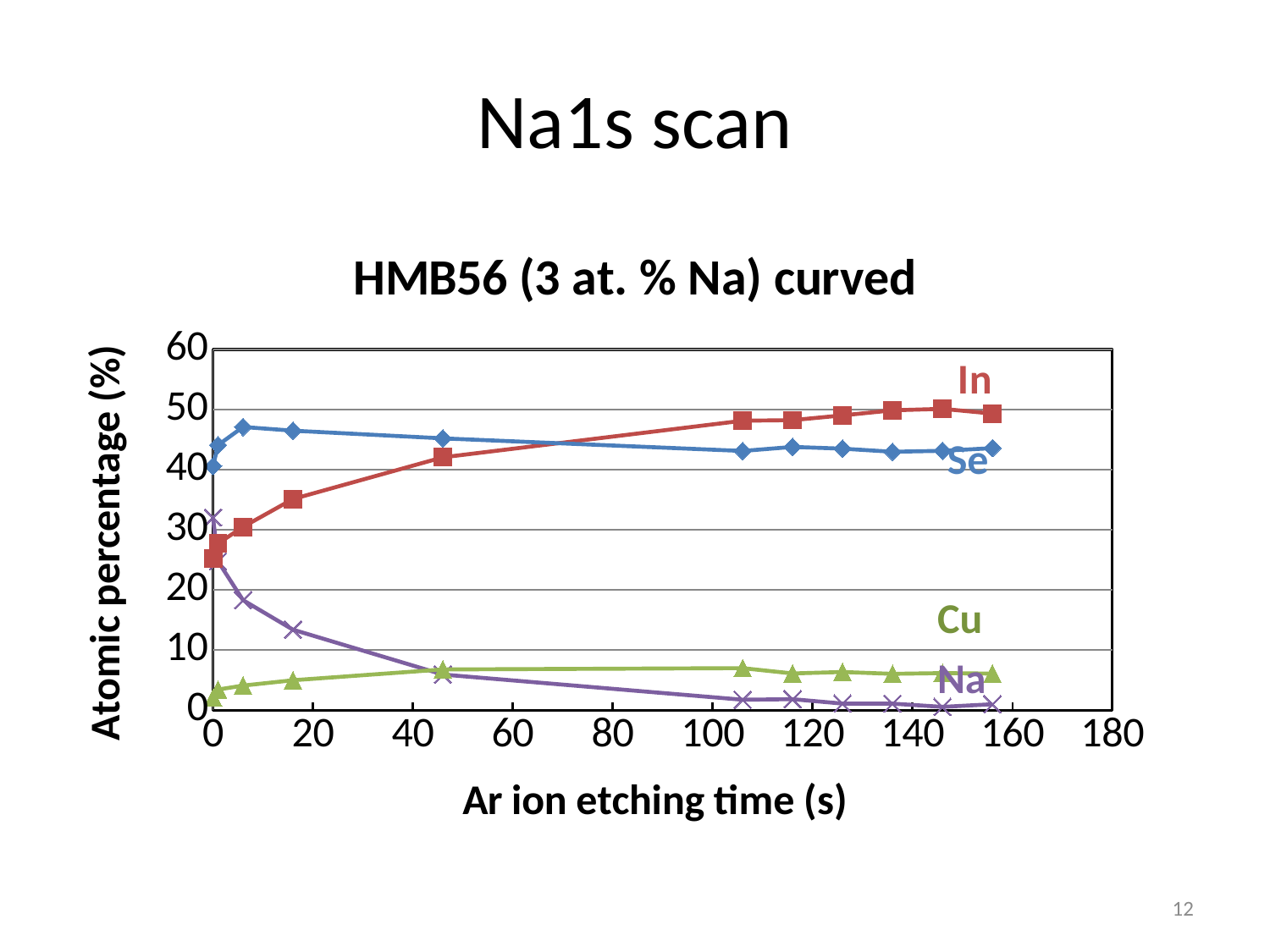
Is the value for Cu at around 106 s greater or less than 10? less How many series are plotted on the chart? 4 Does the Na series rise or fall as Ar ion etching time increases? fall At around 156 s etching time, which series has the larger atomic percentage, In or Se? In What is the label of the x axis? Ar ion etching time (s) Which series has the highest atomic percentage at the longest etching time shown? In What is the title of the chart? HMB56 (3 at. % Na) curved Which series has the lowest atomic percentage at the longest etching time shown? Na What kind of chart is shown on the slide? line chart Is the value for In at around 46 s greater or less than 40? greater At 0 s etching time, which series has the larger atomic percentage, Se or In? Se Does the In series rise or fall as Ar ion etching time increases? rise